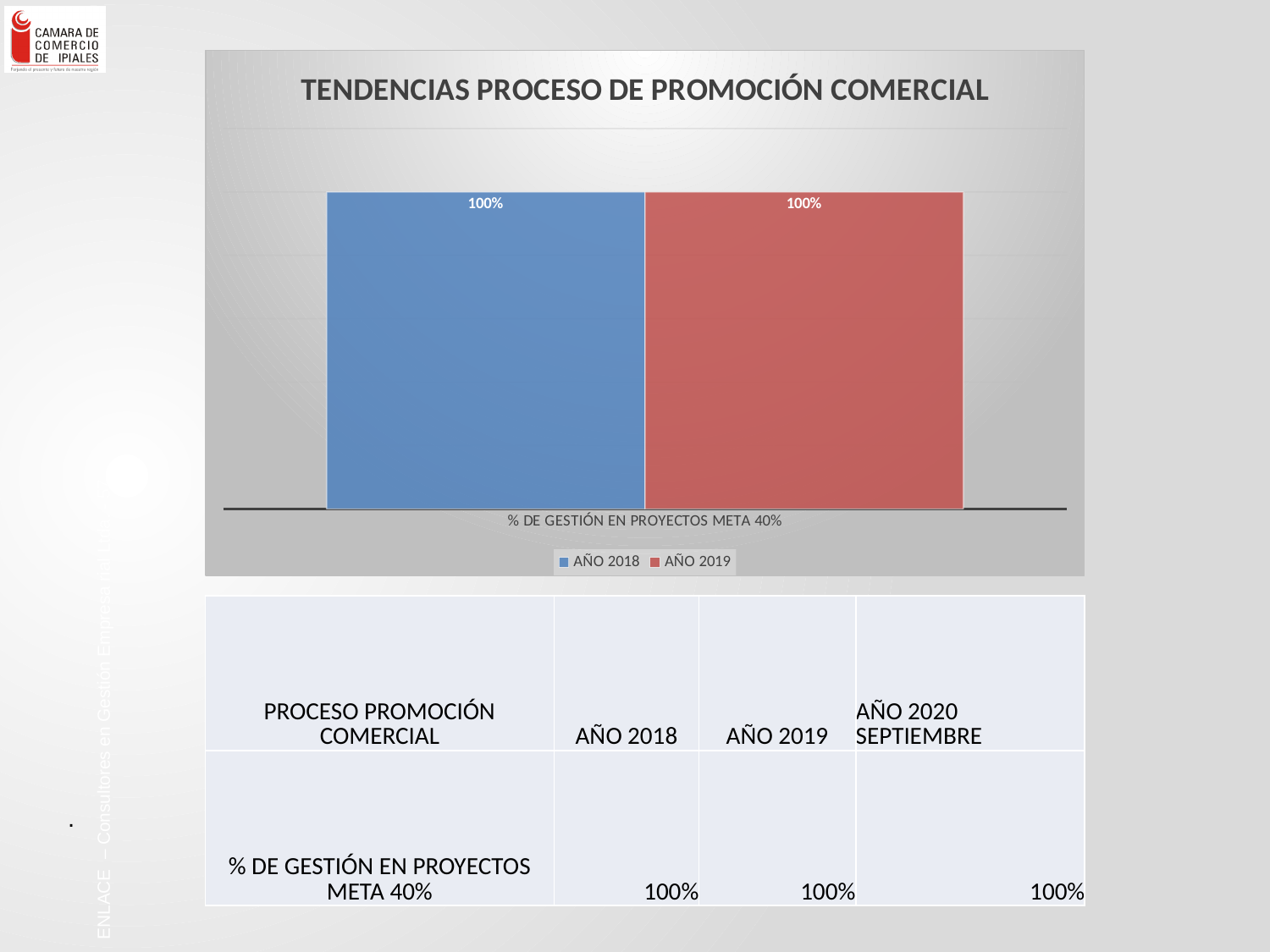
What is the value for AÑO 2018 in the chart? 100% What kind of chart is shown on the slide? bar chart How many series does the chart legend list? 2 Which series is shown in red in the chart? AÑO 2019 What is the title of the chart? TENDENCIAS PROCESO DE PROMOCIÓN COMERCIAL Is the value for AÑO 2018 greater or less than 50%? greater What is the difference between the AÑO 2018 and AÑO 2019 values in the chart? 0% What is the value for AÑO 2019 in the chart? 100% How many categories are shown on the x axis of the chart? 1 What is the category label shown on the x axis of the chart? % DE GESTIÓN EN PROYECTOS META 40%